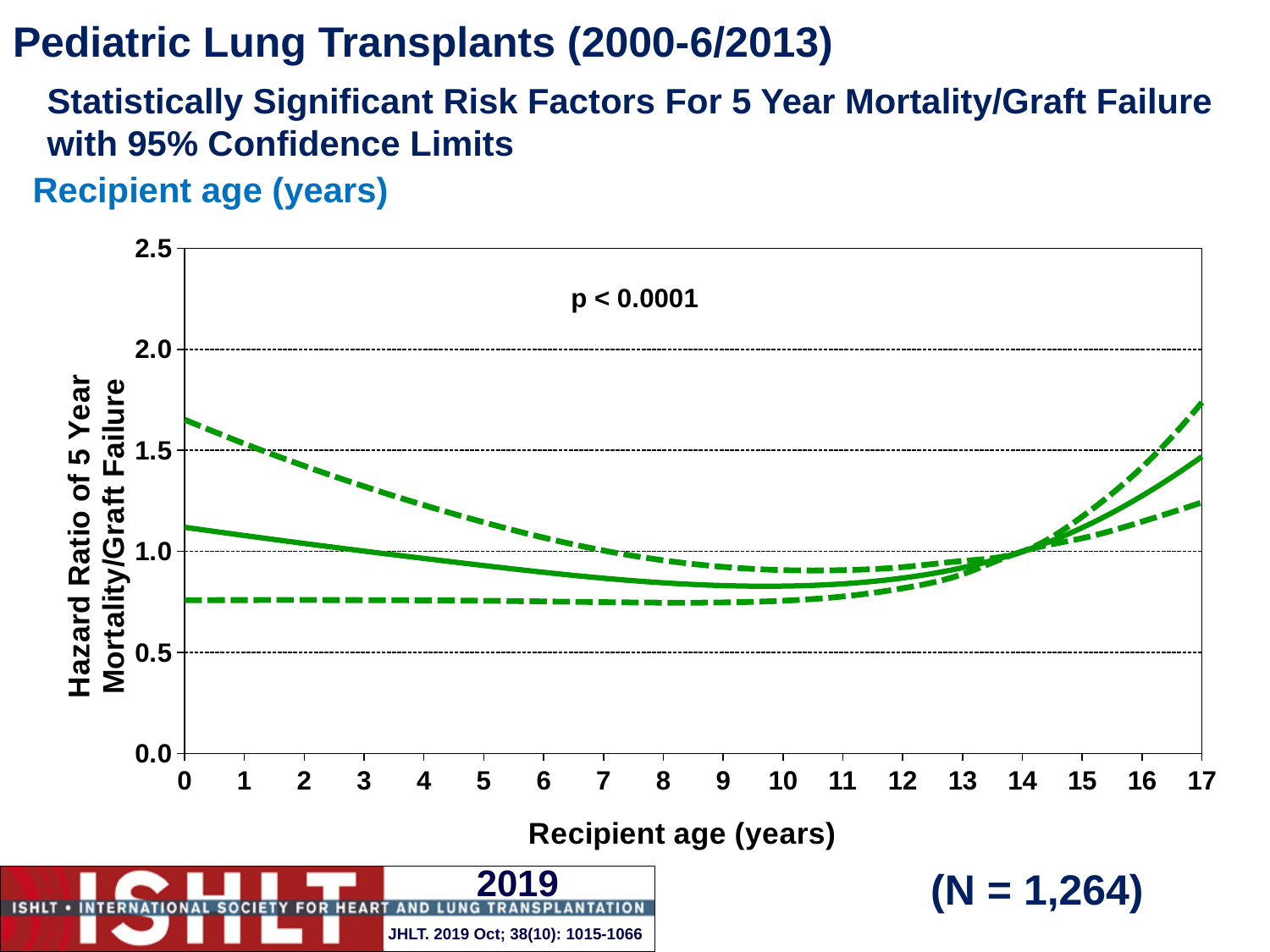
Does the solid line rise or fall between recipient age 11 and recipient age 17? rise How many lines are plotted on the chart? 3 Is the value of the lower dashed line at recipient age 0 greater or less than 1.0? less Is the solid line higher at recipient age 0 or at recipient age 17? recipient age 17 Is the value of the solid line at recipient age 0 greater or less than 1.0? greater What p-value is printed on the chart? p < 0.0001 Is the value of the upper dashed line at recipient age 0 greater or less than 1.5? greater Does the solid line rise or fall between recipient age 0 and recipient age 9? fall What kind of chart is shown on the slide? line chart What is the label of the y axis? Hazard Ratio of 5 Year Mortality/Graft Failure